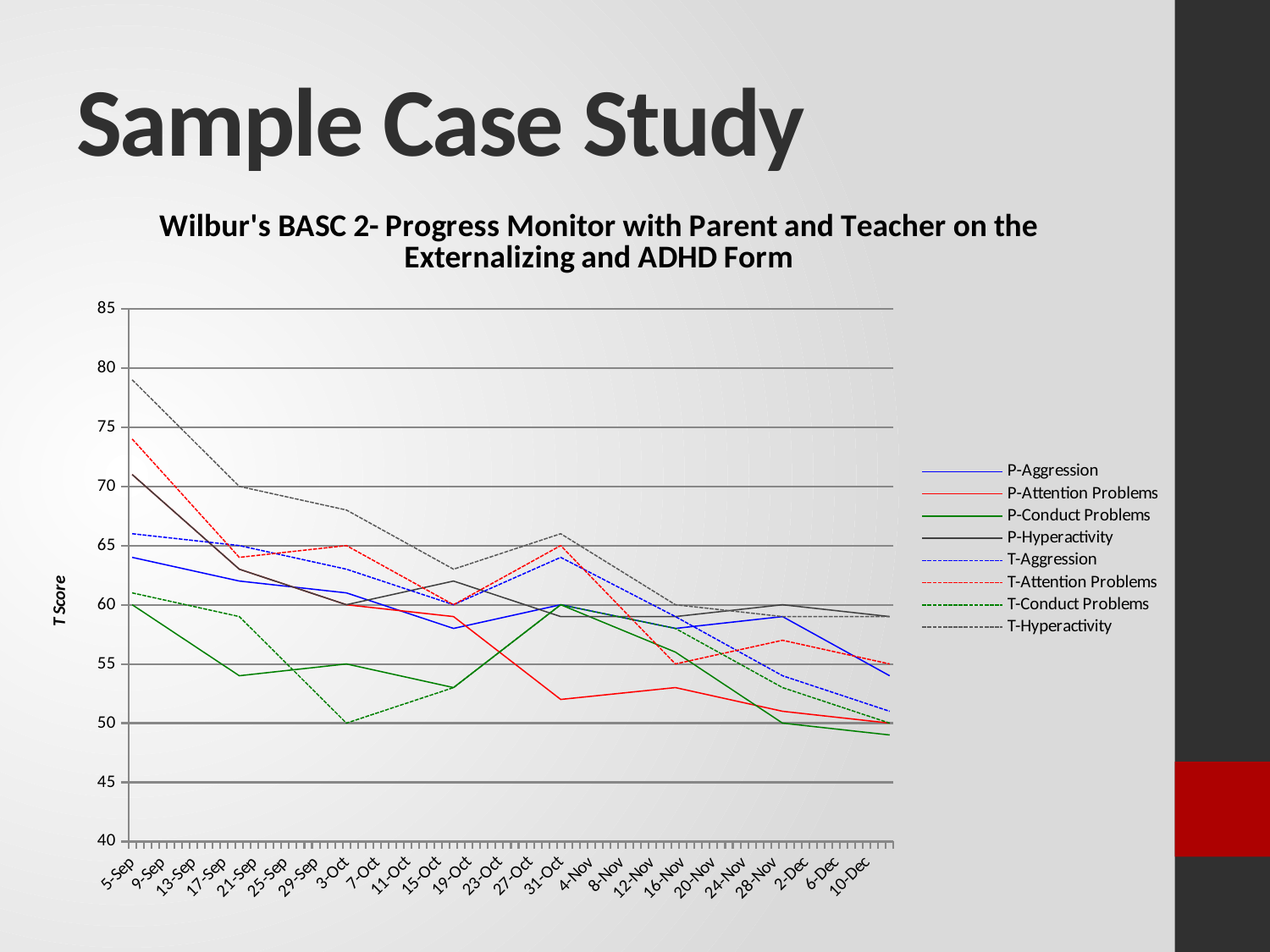
What kind of chart is shown on the slide? Line chart Is the value for T-Attention Problems at 5-Sep greater or less than 70? greater How many series does the legend list? 8 Is the value for T-Hyperactivity at 5-Sep greater or less than 75? greater What is the title of the chart? Wilbur's BASC 2- Progress Monitor with Parent and Teacher on the Externalizing and ADHD Form Which series has the lowest value at 3-Oct? T-Conduct Problems At 5-Sep, which is larger: T-Hyperactivity or T-Attention Problems? T-Hyperactivity What is the label on the vertical axis? T Score Does the T-Hyperactivity series generally rise or fall from 5-Sep to 10-Dec? Fall Which series has the highest value at 5-Sep? T-Hyperactivity At 3-Oct, which is larger: P-Conduct Problems or T-Conduct Problems? P-Conduct Problems Is the value for T-Conduct Problems at 3-Oct greater or less than 55? less